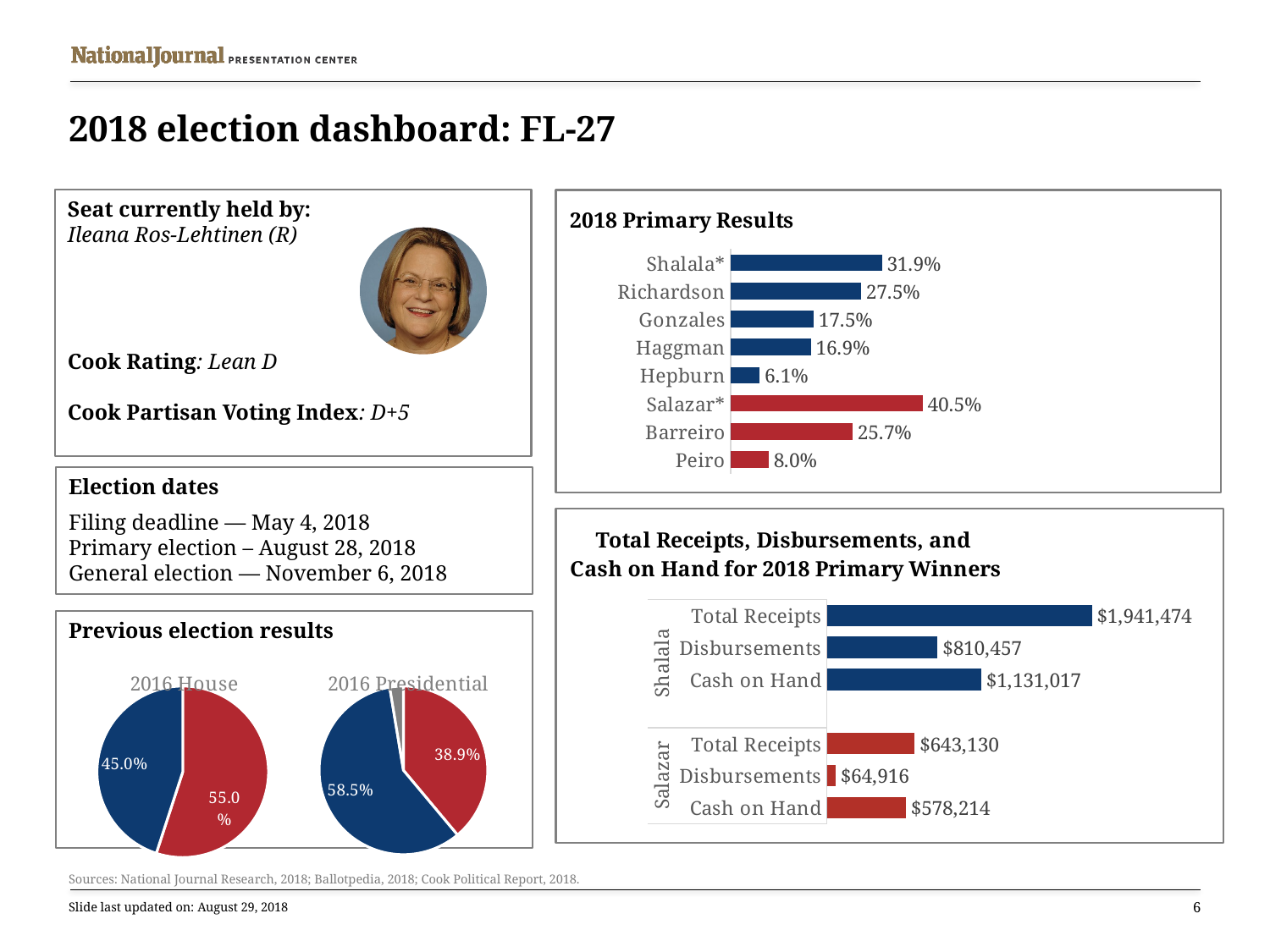
In the 2018 Primary Results chart, which candidate has the highest percentage? Salazar* In the Total Receipts, Disbursements, and Cash on Hand chart, what is the difference between Shalala's and Salazar's Cash on Hand? $552,803 In the 2018 Primary Results chart, who received a larger share, Gonzales or Haggman? Gonzales What type of chart is the 2018 Primary Results chart? Bar chart In the 2018 Primary Results chart, what is the difference between Salazar*'s and Barreiro's percentages? 14.8% In the 2016 House pie chart, what share does the red slice represent? 55.0% In the 2016 Presidential pie chart, what share does the blue slice represent? 58.5% In the Total Receipts, Disbursements, and Cash on Hand chart, what are Shalala's Total Receipts? $1,941,474 In the Total Receipts, Disbursements, and Cash on Hand chart, what are Salazar's Disbursements? $64,916 In the 2018 Primary Results chart, how many candidates are shown? 8 In the 2018 Primary Results chart, which candidate has the lowest percentage? Hepburn In the 2018 Primary Results chart, what percentage did Shalala* receive? 31.9%